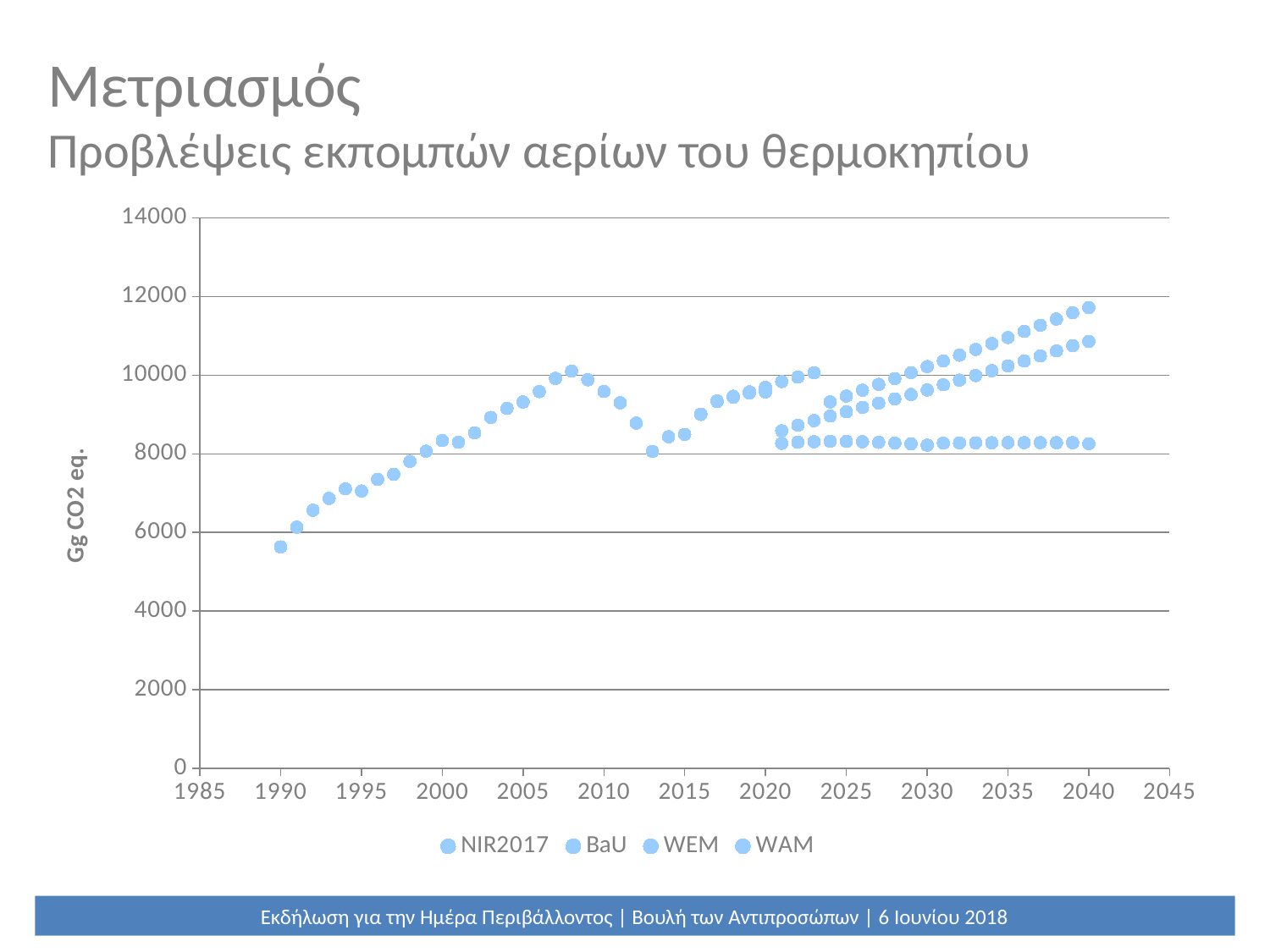
How many series does the legend list? 4 What kind of chart is shown on the slide? scatter chart Do the plotted values rise or fall between 2008 and 2013? fall What is the earliest year with a plotted point on the chart? 1990 Do the plotted values rise or fall between 1990 and 2007? rise Is the plotted value for 2000 greater or less than 8000? greater Is the highest plotted value in 2040 greater or less than 12000? less What is the title of the vertical axis? Gg CO2 eq. Is the plotted value for 1990 greater or less than 6000? less What are the series names listed in the legend? NIR2017, BaU, WEM, WAM